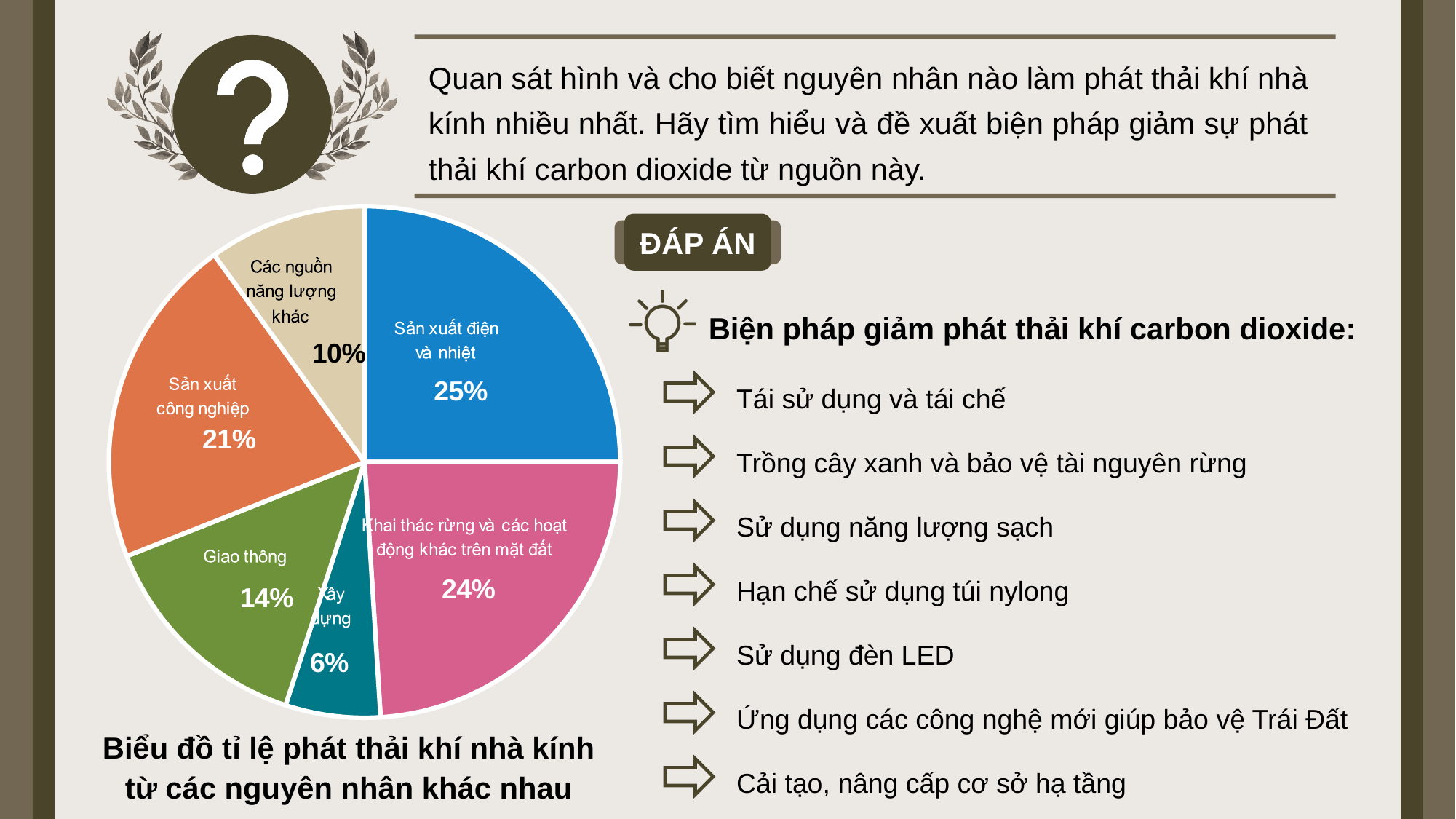
What percentage is shown for "Sản xuất công nghiệp"? 21% What percentage is shown for "Xây dựng" in the pie chart? 6% What is the difference in percentage points between "Sản xuất công nghiệp" and "Giao thông"? 7 Which category has the largest share in the pie chart? Sản xuất điện và nhiệt What is the title written below the pie chart? Biểu đồ tỉ lệ phát thải khí nhà kính từ các nguyên nhân khác nhau What percentage of greenhouse gas emissions does the pie chart attribute to "Sản xuất điện và nhiệt"? 25% Which is larger: the share for "Khai thác rừng và các hoạt động khác trên mặt đất" or the share for "Sản xuất công nghiệp"? Khai thác rừng và các hoạt động khác trên mặt đất What kind of chart is shown on the slide? Pie chart What percentage is shown for "Các nguồn năng lượng khác"? 10% How many slices does the pie chart have? 6 What share does "Giao thông" have in the pie chart? 14% Which category has the smallest share in the pie chart? Xây dựng